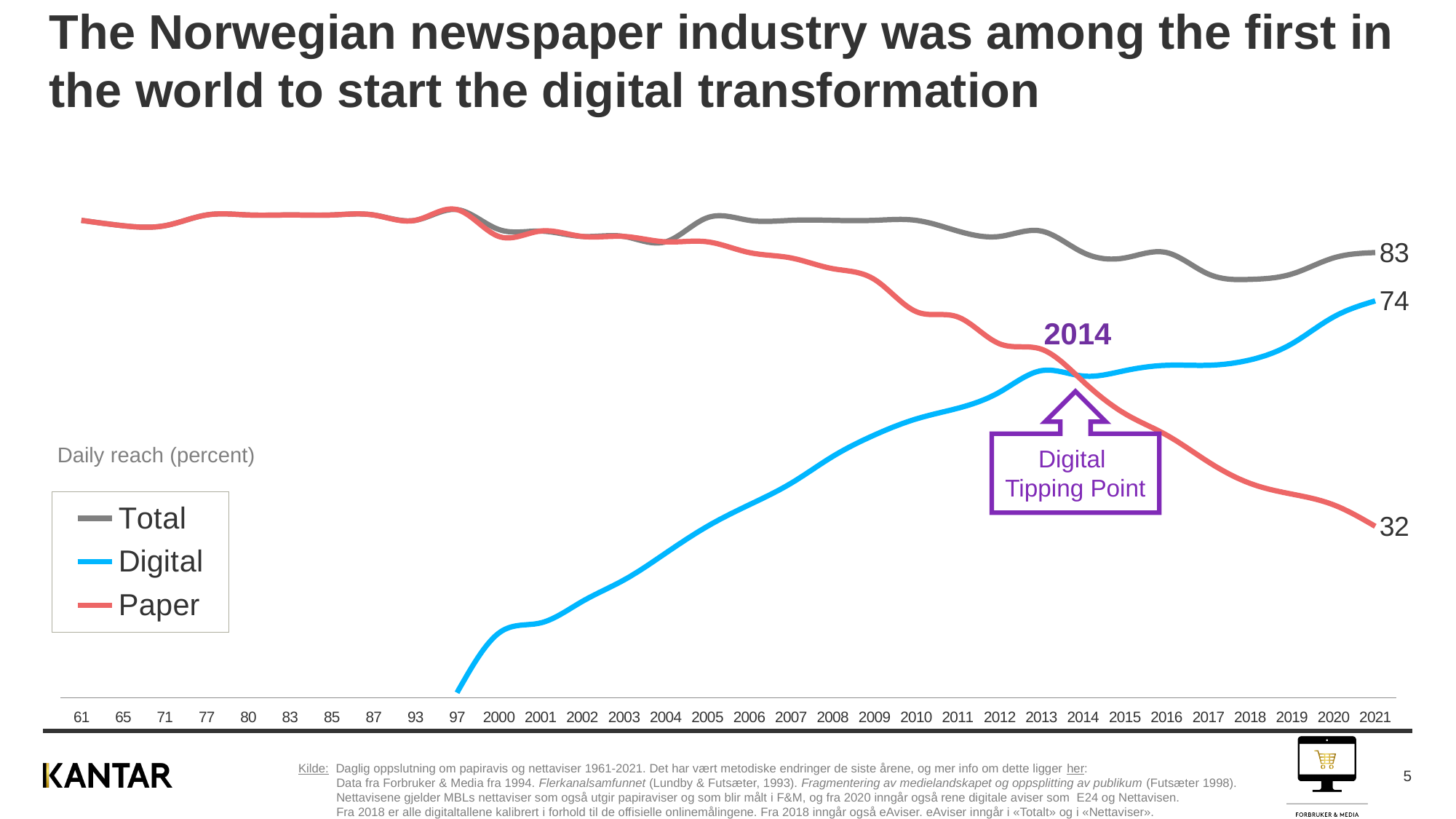
What type of chart is shown on the slide? line chart Which series has the lowest value in 2021? Paper What is the value for Paper in 2021? 32 What is the difference between the Total and Paper values in 2021? 51 What is the value for Digital in 2021? 74 Which year is labelled as the Digital Tipping Point? 2014 What is the value for Total in 2021? 83 In 2021, which is larger: the Digital value or the Paper value? Digital How many series does the legend list? 3 What is the difference between the Digital and Paper values in 2021? 42 Which series has the highest value in 2021? Total Does the Paper series rise or fall from 2010 to 2021? fall